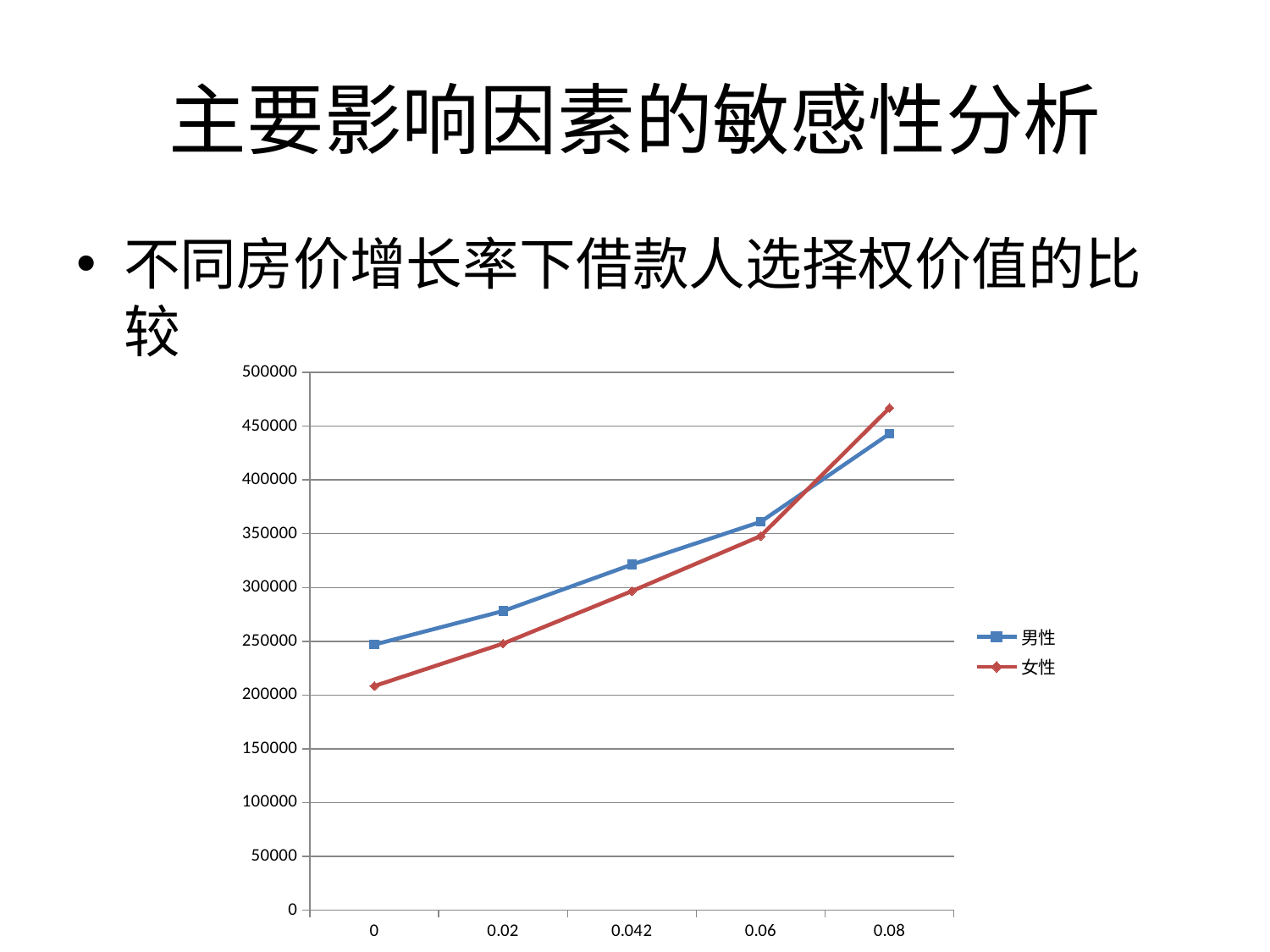
At x = 0, which series has the larger value, 男性 or 女性? 男性 Is the value for 男性 at x = 0.042 greater or less than 300000? greater Is the value for 女性 at x = 0 greater or less than 250000? less At which x value does the 女性 series reach its lowest point? 0 How many series does the legend list? 2 Do the values for 男性 rise or fall as the x axis goes from 0 to 0.08? rise Do the values for 女性 rise or fall as the x axis goes from 0 to 0.08? rise At x = 0.08, which series has the larger value, 男性 or 女性? 女性 Which series is drawn in red? 女性 Is the value for 男性 at x = 0.08 greater or less than 400000? greater How many points are plotted along the x axis for each series? 5 What kind of chart is shown on the slide? line chart